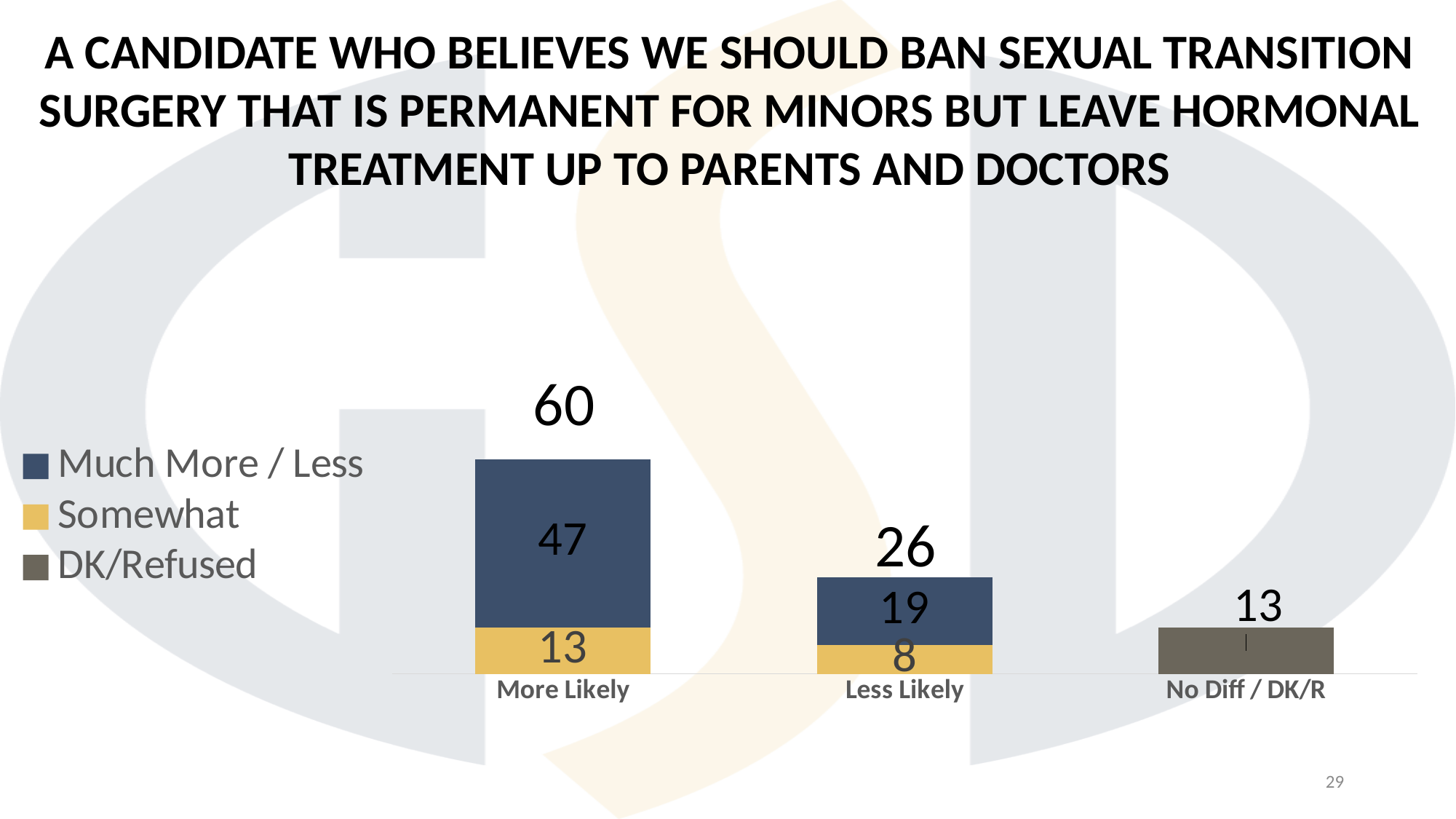
What is the difference between the 'Much More / Less' values for More Likely and Less Likely? 28 How many series does the legend list? 3 Which category has the lowest total? No Diff / DK/R Which is larger: the 'Somewhat' value for More Likely or for Less Likely? More Likely Which category has the highest total? More Likely What is the 'Much More / Less' value for the More Likely bar? 47 What is the total shown above the Less Likely bar? 26 What is the 'Somewhat' value for the Less Likely bar? 8 What is the total shown above the More Likely bar? 60 What is the value for the No Diff / DK/R bar? 13 How many categories are shown on the x axis? 3 What kind of chart is shown on the slide? Stacked bar chart